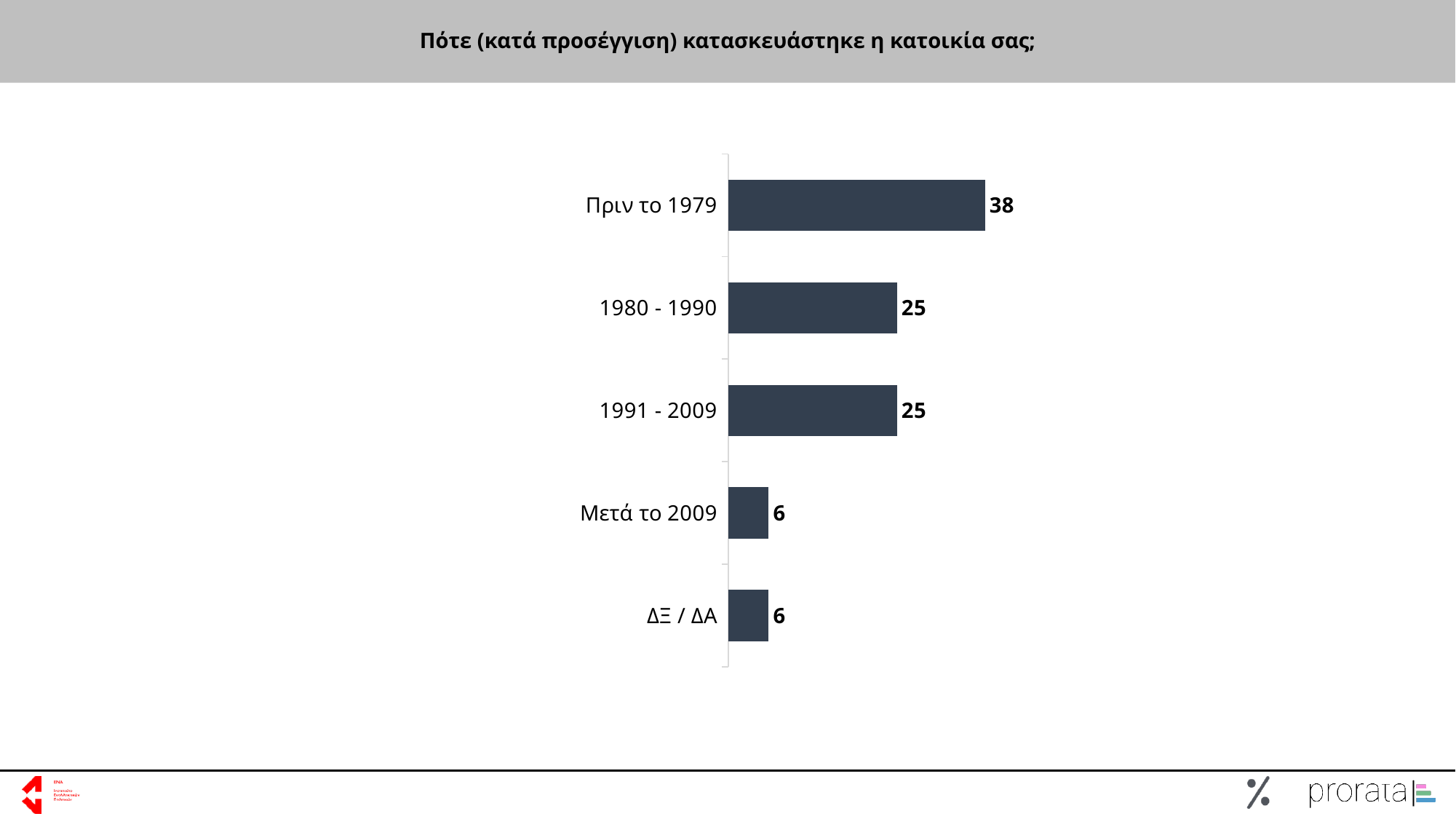
What is the title of the slide? Πότε (κατά προσέγγιση) κατασκευάστηκε η κατοικία σας; Which category has the highest value? Πριν το 1979 What is the value for 'Μετά το 2009'? 6 What is the value for 'ΔΞ / ΔΑ'? 6 What kind of chart is shown on the slide? bar chart Which is larger, the value for '1991 - 2009' or the value for 'Μετά το 2009'? 1991 - 2009 How many categories are shown in the chart? 5 What is the difference between the values for 'Πριν το 1979' and '1980 - 1990'? 13 What is the value for 'Πριν το 1979'? 38 Do the values for '1980 - 1990' and '1991 - 2009' differ? No, both are 25 What is the value for '1980 - 1990'? 25 What is the difference between the values for '1991 - 2009' and 'Μετά το 2009'? 19